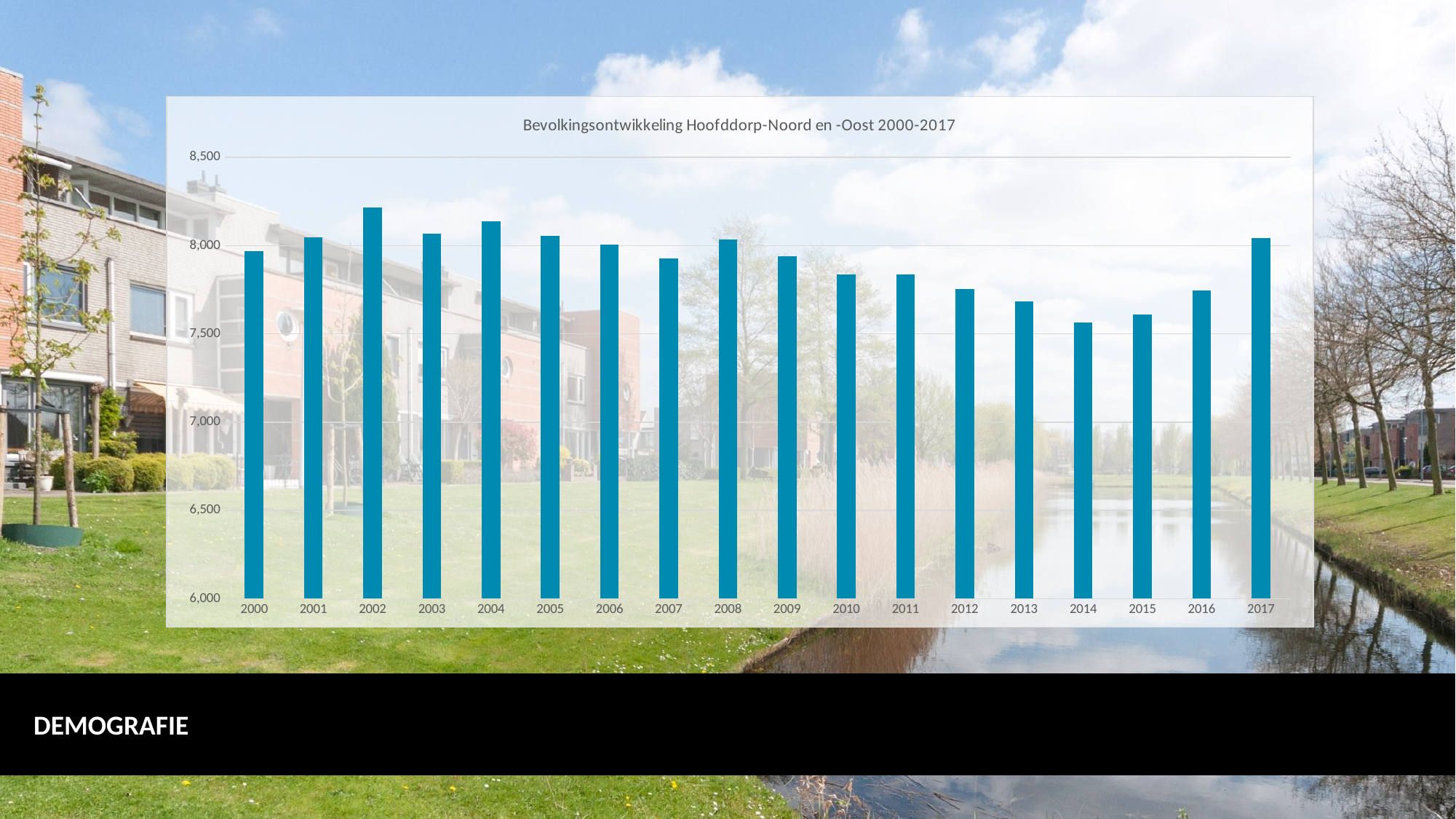
What is the title of the chart? Bevolkingsontwikkeling Hoofddorp-Noord en -Oost 2000-2017 How many years are plotted on the x axis of the chart? 18 Is the value for 2014 greater or less than 7,500? greater Is the value for 2002 greater or less than 8,000? greater What kind of chart is shown on the slide? bar chart Is the value for 2000 greater or less than 8,000? less Do the values generally rise or fall from 2002 to 2014? fall What colour are the bars in the chart? blue Which year has the lowest bar in the chart? 2014 Which year has the larger value, 2004 or 2013? 2004 Which year has the highest bar in the chart? 2002